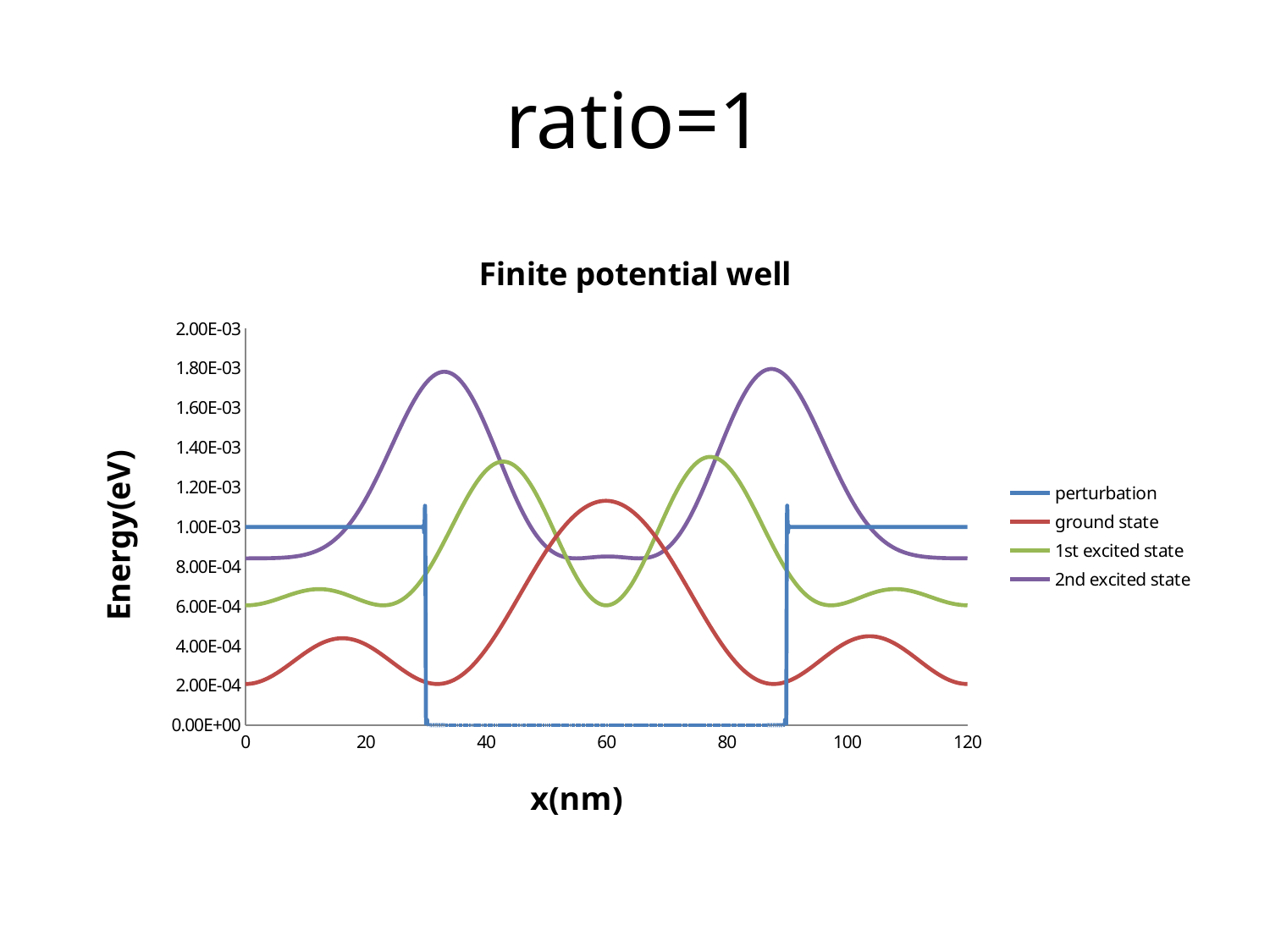
Does the ground state rise or fall as x goes from 30 nm to 60 nm? rise Is the peak value of the 2nd excited state greater or less than 1.60E-03? greater Is the value of the ground state at x = 60 nm greater or less than 1.00E-03? greater How many series does the legend list? 4 Is the value of the 1st excited state at x = 0 nm greater or less than 8.00E-04? less What kind of chart is shown on the slide? line chart What is the label of the y axis? Energy(eV) What is the value of the perturbation series at x = 10 nm? 1.00E-03 What is the value of the perturbation series at x = 60 nm? 0.00E+00 At x = 60 nm, which is higher: the ground state or the 1st excited state? ground state What is the title of the chart? Finite potential well Which series reaches the highest value on the chart? 2nd excited state